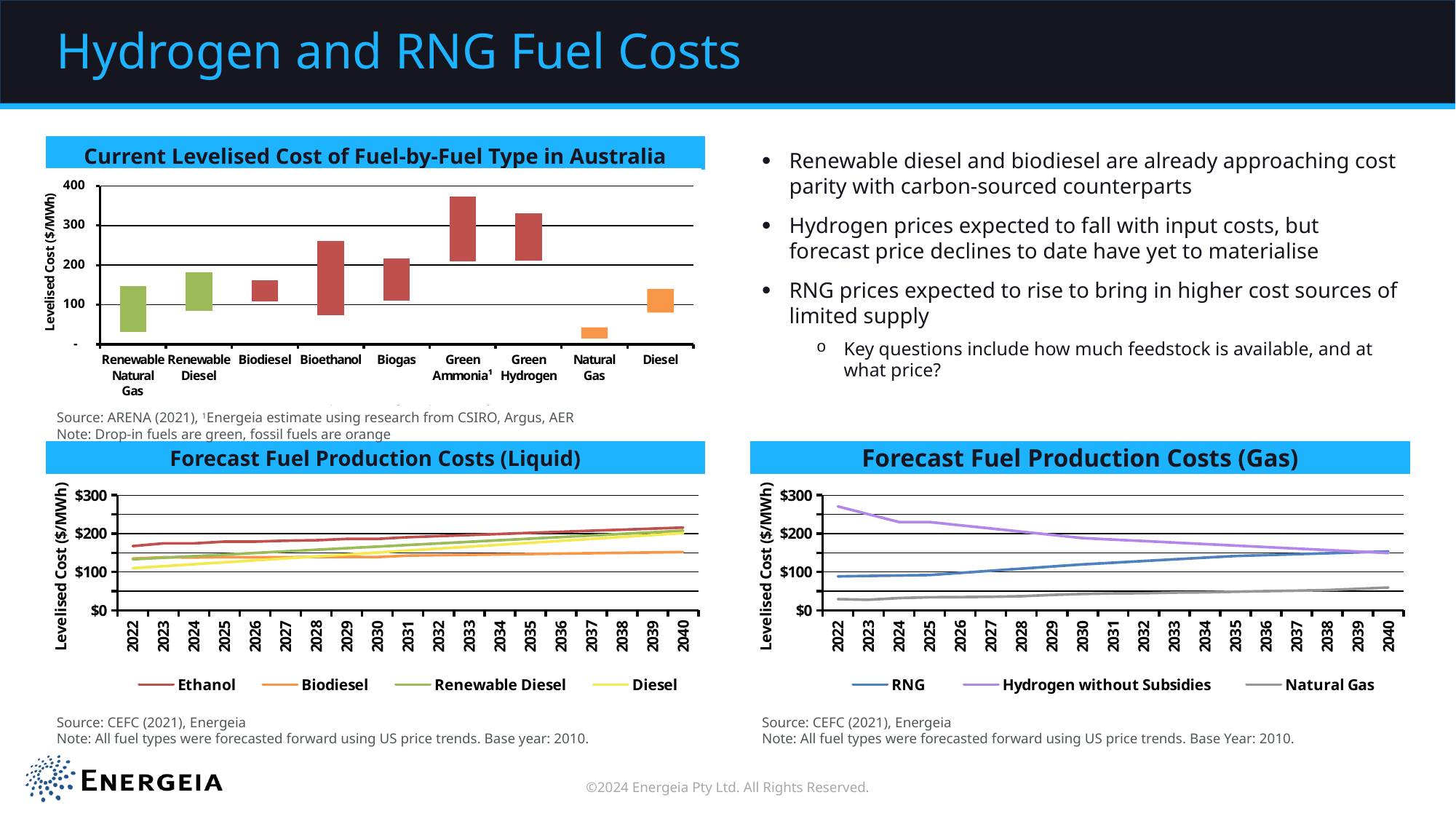
In the 'Forecast Fuel Production Costs (Gas)' chart, does the 'Hydrogen without Subsidies' line rise or fall from 2022 to 2040? Fall In the 'Current Levelised Cost of Fuel-by-Fuel Type in Australia' chart, which fuel type has the lowest levelised cost? Natural Gas In the 'Current Levelised Cost of Fuel-by-Fuel Type in Australia' chart, which fuel type reaches the highest levelised cost? Green Ammonia In the 'Forecast Fuel Production Costs (Gas)' chart, how many series does the legend list? 3 In the 'Current Levelised Cost of Fuel-by-Fuel Type in Australia' chart, how many fuel types are shown on the x axis? 9 In the 'Current Levelised Cost of Fuel-by-Fuel Type in Australia' chart, what kind of chart is shown? Bar chart In the 'Current Levelised Cost of Fuel-by-Fuel Type in Australia' chart, is the top of the Green Hydrogen bar greater or less than 300? greater In the 'Forecast Fuel Production Costs (Liquid)' chart, which fuel has the highest cost in 2022? Ethanol In the 'Forecast Fuel Production Costs (Liquid)' chart, how many series does the legend list? 4 In the 'Current Levelised Cost of Fuel-by-Fuel Type in Australia' chart, is the top of the Natural Gas bar greater or less than 100? less In the 'Forecast Fuel Production Costs (Liquid)' chart, does the Diesel line rise or fall from 2022 to 2040? Rise In the 'Forecast Fuel Production Costs (Gas)' chart, is the value for Hydrogen without Subsidies in 2022 greater or less than $200? greater